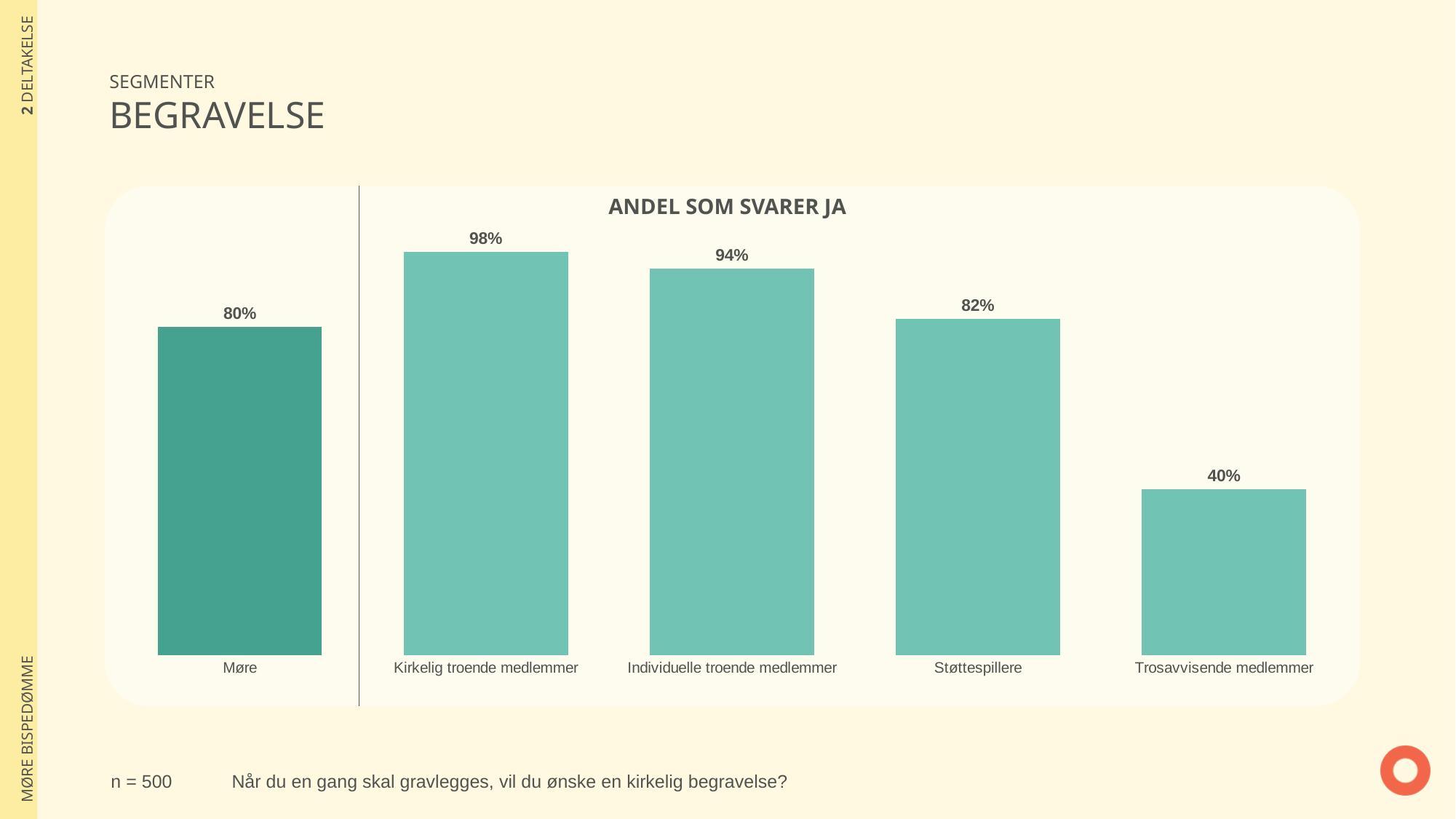
Which is larger, the value for Støttespillere or the value for Møre? Støttespillere What is the difference between the values for Individuelle troende medlemmer and Møre? 14% How many categories are shown in the chart? 5 What is the value for Trosavvisende medlemmer? 40% Which category has the highest value? Kirkelig troende medlemmer What is the difference between the values for Kirkelig troende medlemmer and Trosavvisende medlemmer? 58% Which category has the lowest value? Trosavvisende medlemmer What kind of chart is shown on the slide? Bar chart What is the value for Møre? 80% What is the value for Støttespillere? 82% What is the value for Kirkelig troende medlemmer? 98% What is the title of the chart? ANDEL SOM SVARER JA